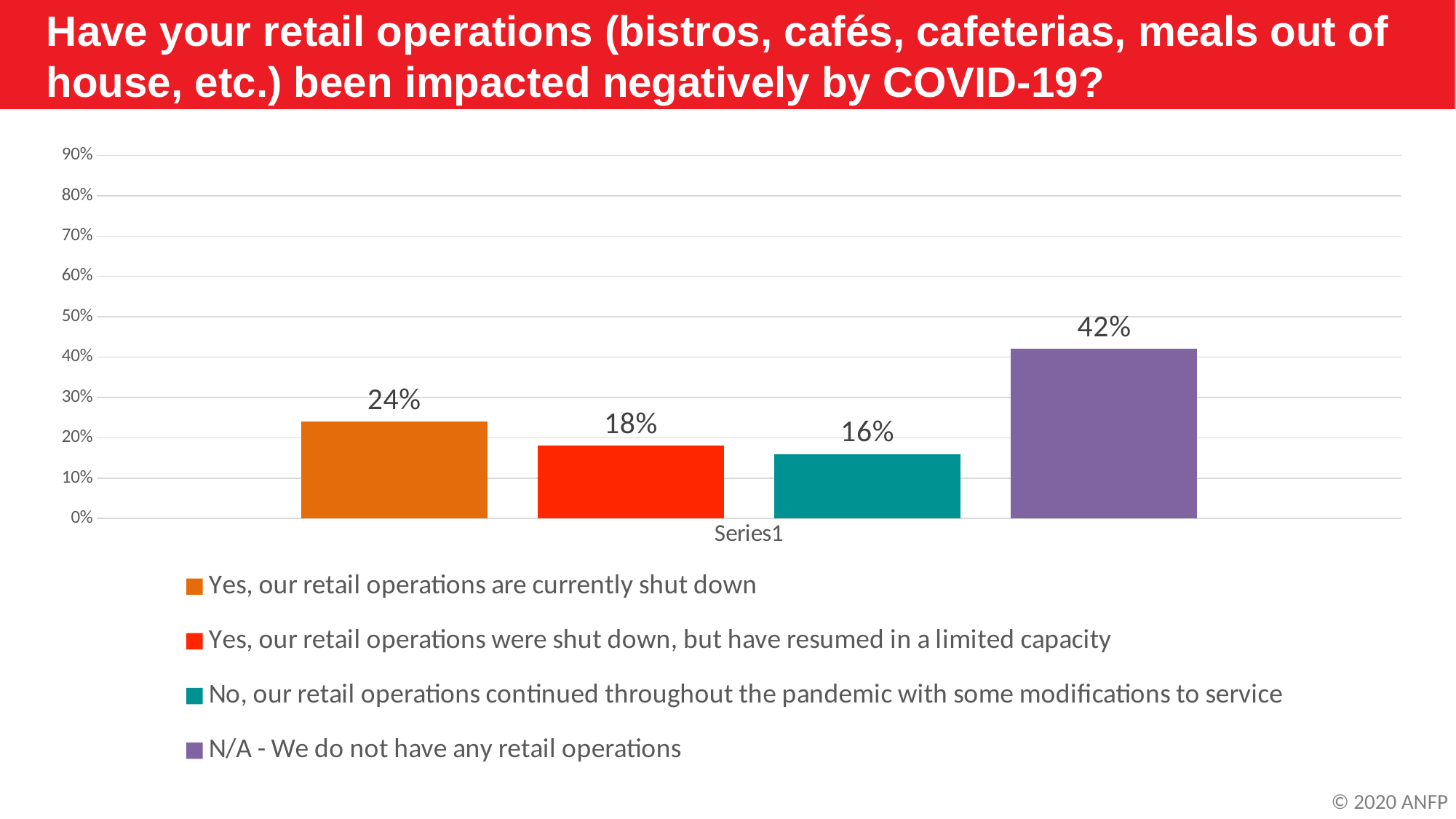
What percentage of respondents said their retail operations are currently shut down? 24% Which response option has the highest percentage? N/A - We do not have any retail operations Which is larger: the share for 'currently shut down' or the share for 'resumed in a limited capacity'? Yes, our retail operations are currently shut down What percentage of respondents said their retail operations were shut down but have resumed in a limited capacity? 18% What percentage of respondents said they do not have any retail operations (N/A)? 42% What colour is the bar for 'N/A - We do not have any retail operations'? purple How many bars are plotted in the chart? 4 What is the difference in percentage points between the N/A response and the 'currently shut down' response? 18 Is the value for 'N/A - We do not have any retail operations' greater or less than 40%? greater What percentage of respondents said their retail operations continued throughout the pandemic with some modifications to service? 16% What type of chart is shown on the slide? bar chart Which response option has the lowest percentage? No, our retail operations continued throughout the pandemic with some modifications to service